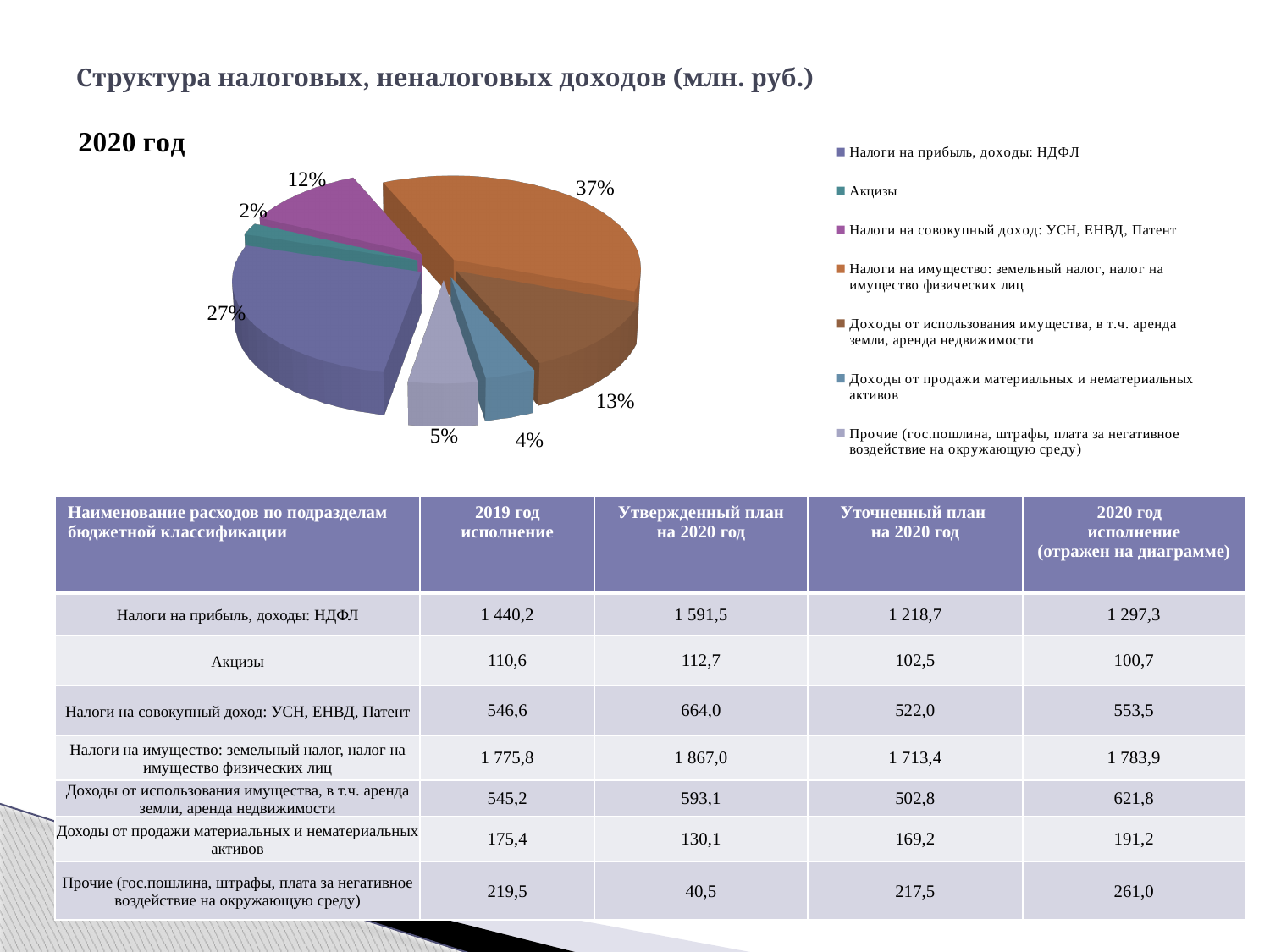
What share of the pie does "Налоги на прибыль, доходы: НДФЛ" have? 27% Which category has the largest slice of the pie chart? Налоги на имущество: земельный налог, налог на имущество физических лиц How many entries does the legend of the pie chart list? 7 What kind of chart is shown on the slide? Pie chart Which category has the smallest slice of the pie chart? Акцизы What is the difference in percentage points between the largest slice (37%) and the "Налоги на прибыль, доходы: НДФЛ" slice (27%)? 10 percentage points Which slice is larger: "Прочие (гос.пошлина, штрафы, плата за негативное воздействие на окружающую среду)" or "Доходы от продажи материальных и нематериальных активов"? Прочие (гос.пошлина, штрафы, плата за негативное воздействие на окружающую среду) What share of the pie does "Налоги на совокупный доход: УСН, ЕНВД, Патент" have? 12% How many slices does the pie chart have? 7 What share of the pie does "Доходы от использования имущества, в т.ч. аренда земли, аренда недвижимости" have? 13%